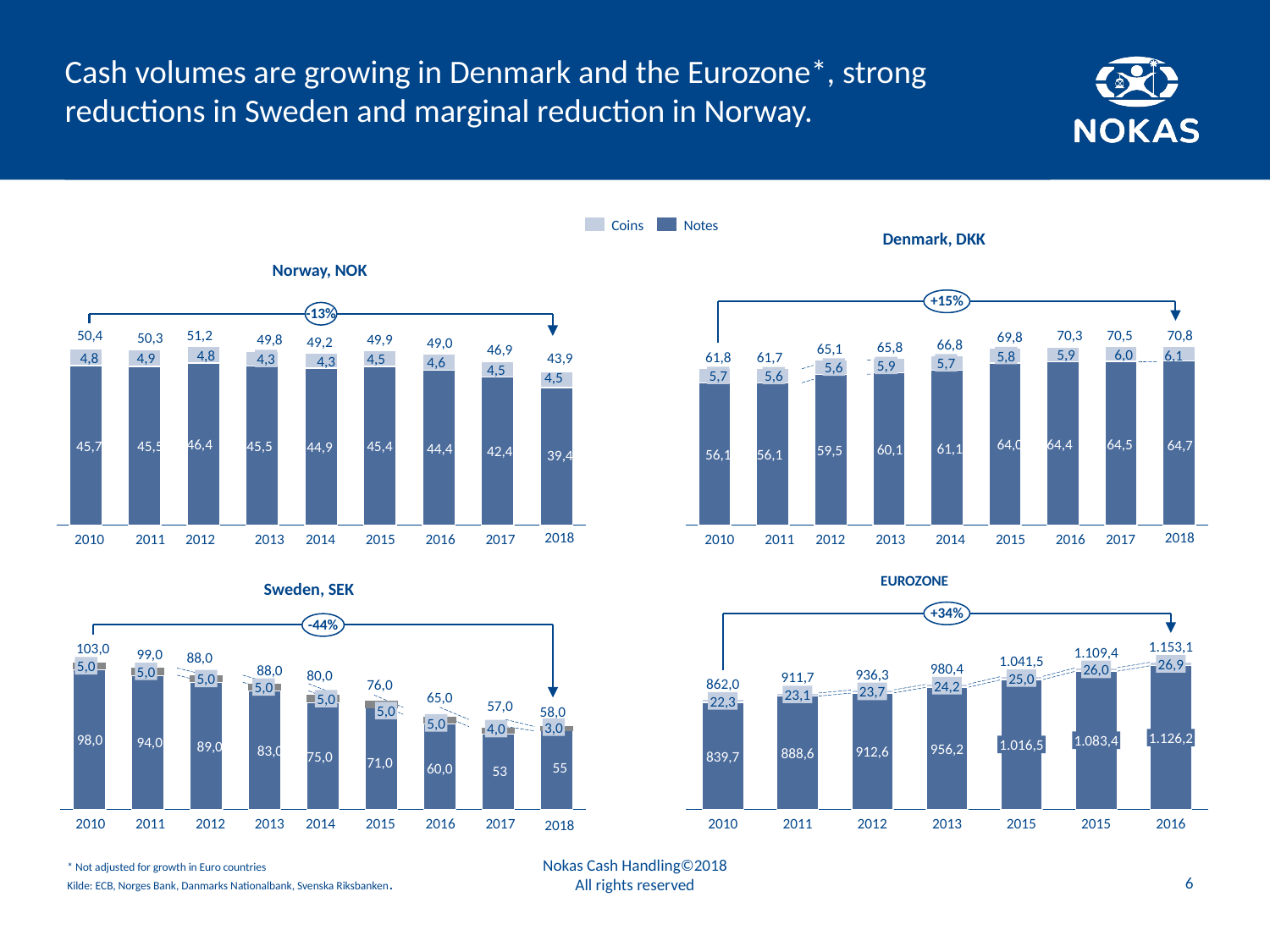
In the Denmark, DKK chart, what is the value of Coins for 2018? 6,1 In the EUROZONE chart, what is the value of Notes for 2016? 1.126,2 In the Norway, NOK chart, what is the total shown above the bar for 2012? 51,2 In the Sweden, SEK chart, which year has the lowest total? 2017 In the Denmark, DKK chart, what is the difference between the Notes values for 2018 and 2010? 8,6 In the EUROZONE chart, do the totals rise or fall from left to right along the x axis? rise In the Norway, NOK chart, what is the value of Notes for 2018? 39,4 How many series does the legend list? 2 In the Sweden, SEK chart, what is the value of Notes for 2010? 98,0 In the Denmark, DKK chart, which year has the highest total? 2018 In the Sweden, SEK chart, what percentage change is shown in the callout above the bars? -44% What kind of chart is the Norway, NOK chart? stacked bar chart